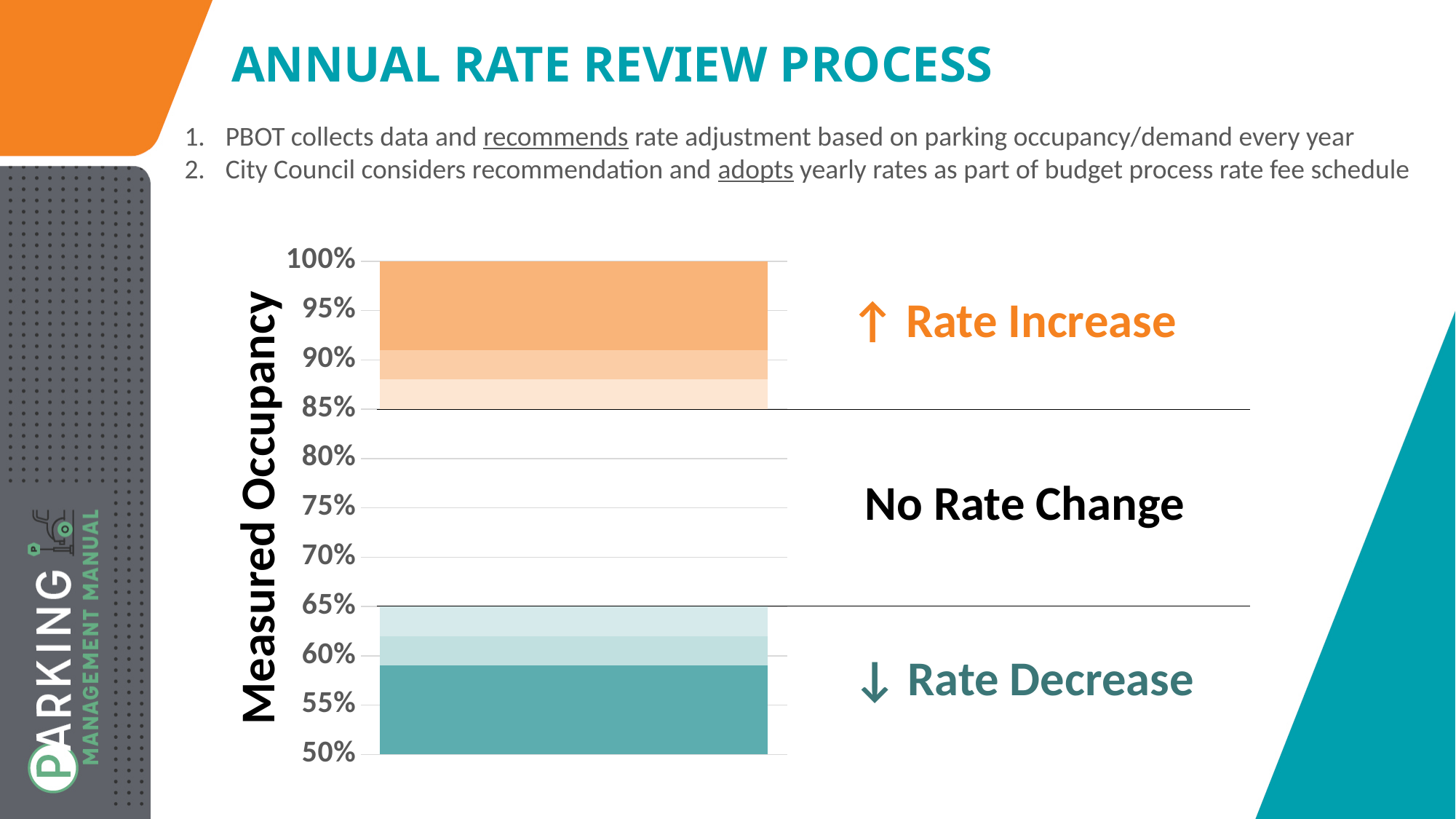
At what measured occupancy does the 'Rate Increase' zone begin on the chart? 85% Which rate outcome is shown for a measured occupancy of 55%? Rate Decrease What is the label on the vertical axis of the chart? Measured Occupancy What colour is the bar in the 'Rate Increase' zone of the chart? orange At what measured occupancy does the 'Rate Decrease' zone end on the chart? 65% Which rate outcome is shown for a measured occupancy of 75%? No Rate Change What kind of chart is shown on the slide? bar chart How many rate outcome zones are labelled on the chart? 3 What is the highest value shown on the vertical axis of the chart? 100% What is the lowest value shown on the vertical axis of the chart? 50% Which rate outcome is shown for a measured occupancy of 95%? Rate Increase What range of measured occupancy corresponds to 'No Rate Change' on the chart? 65% to 85%